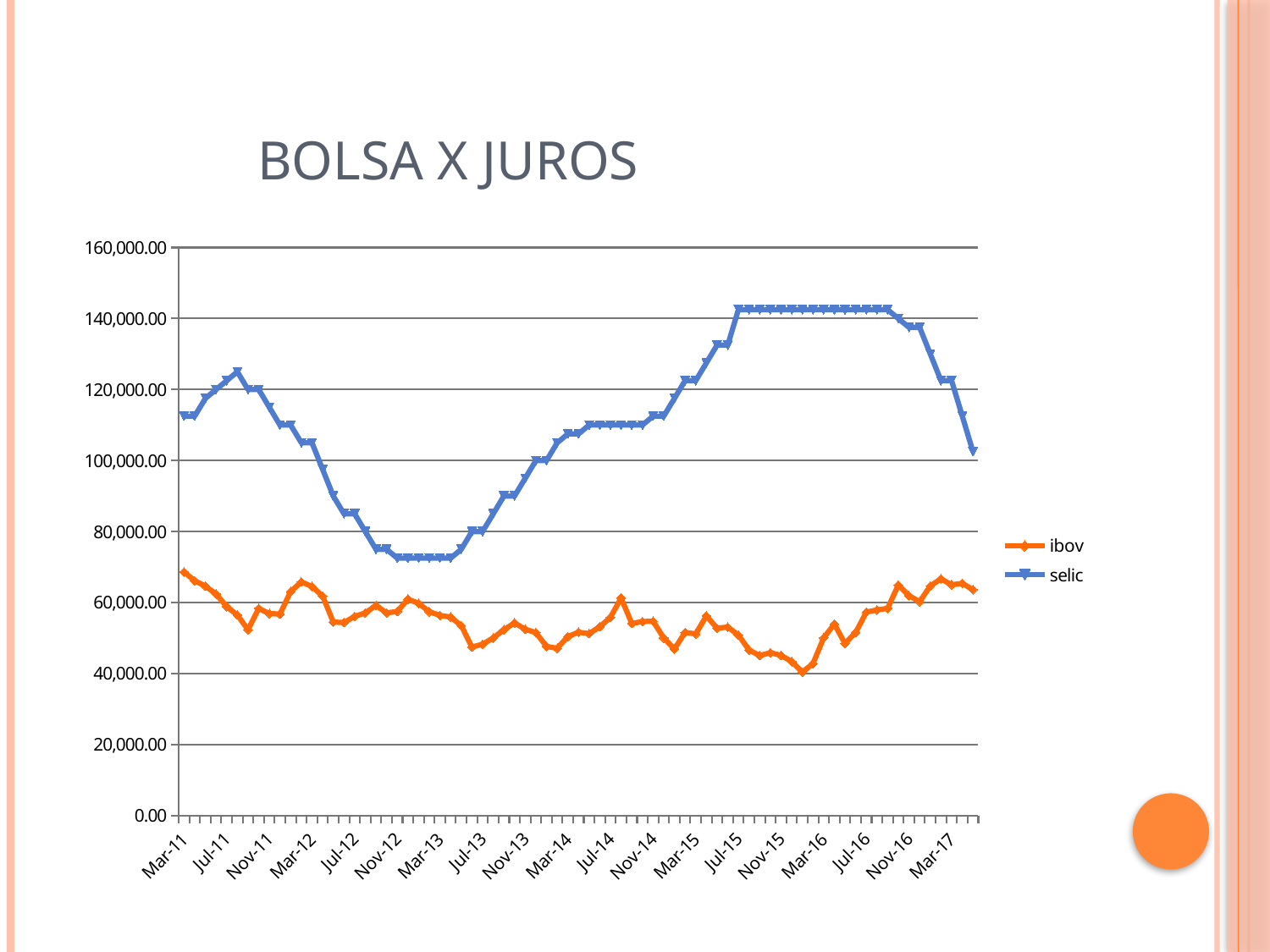
Is the value of selic at Nov-15 greater or less than 140,000.00? greater How many series does the legend list? 2 Does the selic series rise or fall between Mar-13 and Jul-15? rise Is the value of selic at Mar-11 greater or less than 100,000.00? greater Which series is drawn in blue? selic What kind of chart is shown on the slide? line chart At Mar-11, which series has the larger value, ibov or selic? selic What is the title of the chart? BOLSA X JUROS Is the value of ibov at Jul-13 greater or less than 60,000.00? less Does the selic series rise or fall between Mar-11 and Nov-12? fall